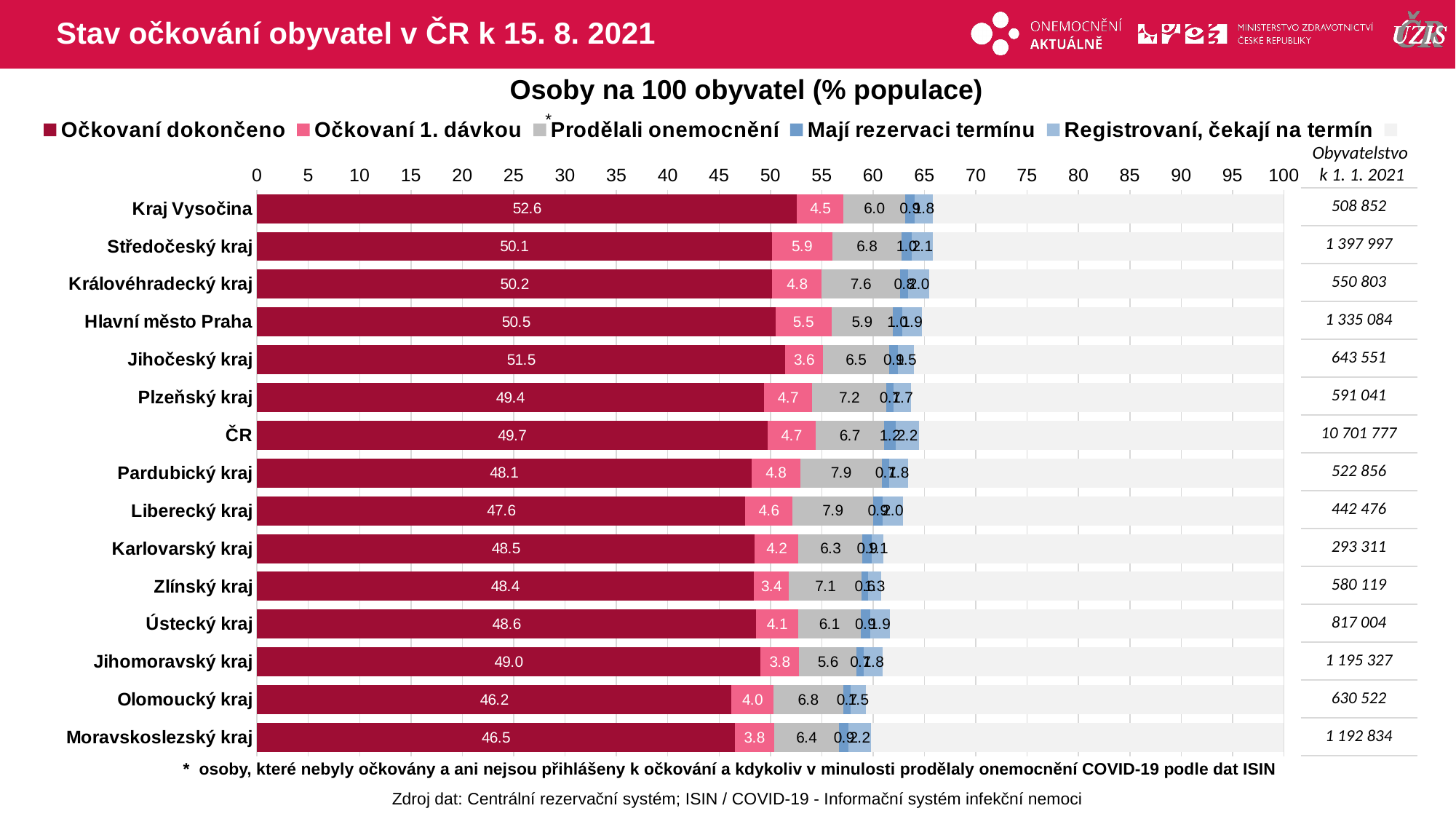
What is the title of the chart? Osoby na 100 obyvatel (% populace) How many categories (rows) are plotted in the chart? 15 What is the value of 'Očkovaní dokončeno' for Kraj Vysočina? 52.6 Is the 'Očkovaní dokončeno' value for Moravskoslezský kraj greater or less than 50? less Which category has the highest value for 'Očkovaní dokončeno'? Kraj Vysočina What is the difference between the 'Očkovaní dokončeno' values for Kraj Vysočina and Olomoucký kraj? 6.4 What kind of chart is shown on the slide? Stacked bar chart Which has a larger 'Očkovaní dokončeno' value, Jihočeský kraj or Hlavní město Praha? Jihočeský kraj Which category has the lowest value for 'Prodělali onemocnění'? Jihomoravský kraj What is the value of 'Očkovaní 1. dávkou' for Středočeský kraj? 5.9 Which category has the lowest value for 'Očkovaní dokončeno'? Olomoucký kraj What is the value of 'Prodělali onemocnění' for Pardubický kraj? 7.9